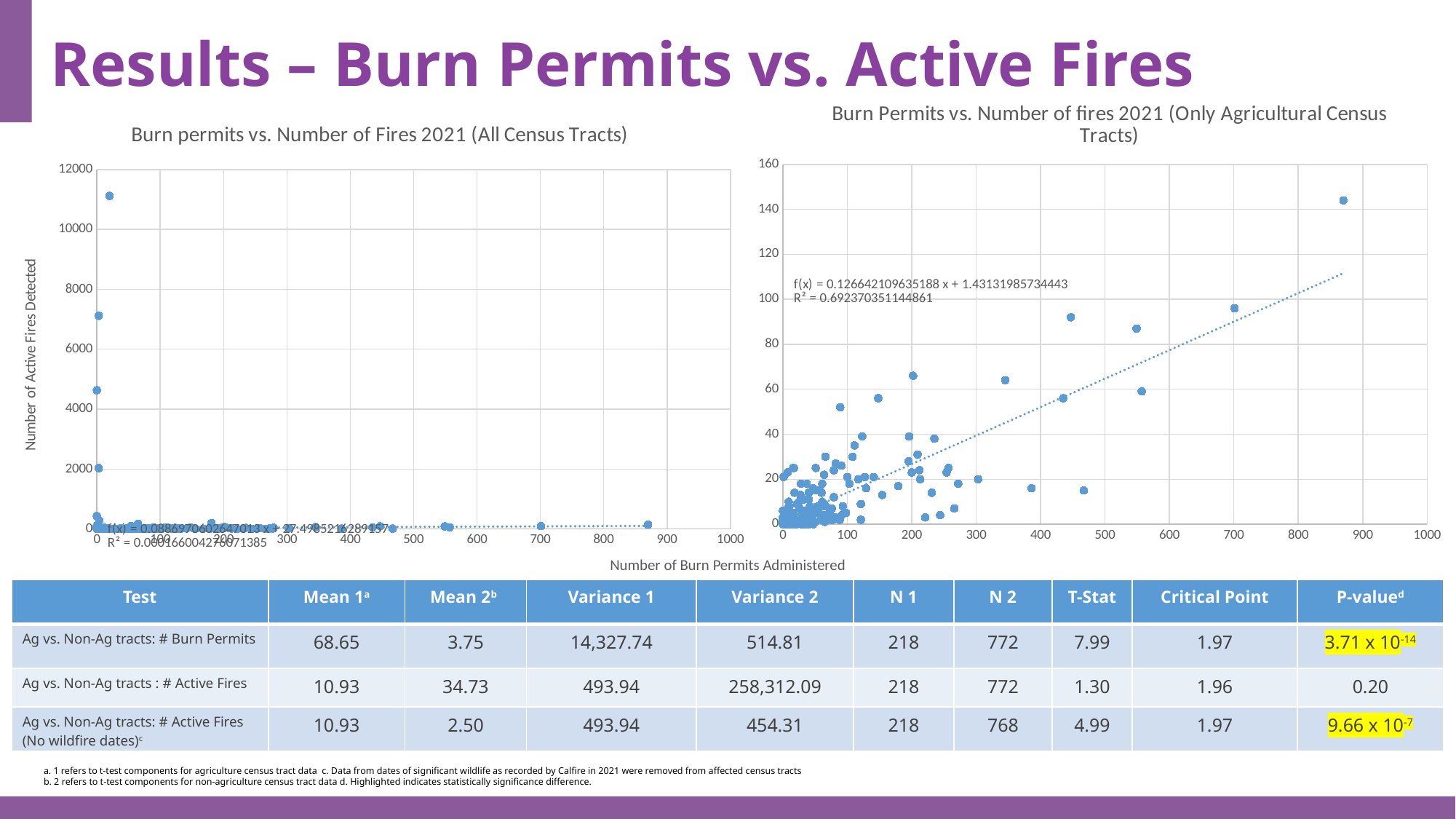
What kind of chart is the left chart, 'Burn permits vs. Number of Fires 2021 (All Census Tracts)'? Scatter chart What is the y-axis label of the left chart? Number of Active Fires Detected In the right chart, which point has more fires: the one near 870 burn permits or the one near 700 burn permits? The one near 870 burn permits In the right chart, what R² value is printed for the trend line? R² = 0.692370351144861 What is the title of the right chart? Burn Permits vs. Number of fires 2021 (Only Agricultural Census Tracts) In the right chart, what is the intercept of the fitted line f(x) shown on the chart? 1.43131985734443 In the left chart, is the highest point greater or less than 10000 active fires? greater In the right chart, is the point near 700 burn permits greater or less than 80 fires? greater In the right chart, does the dotted trend line rise or fall as the number of burn permits increases? Rises In the right chart, what is the slope of the fitted line f(x) shown on the chart? 0.126642109635188 In the left chart, is the point near 870 burn permits greater or less than 2000 active fires? less